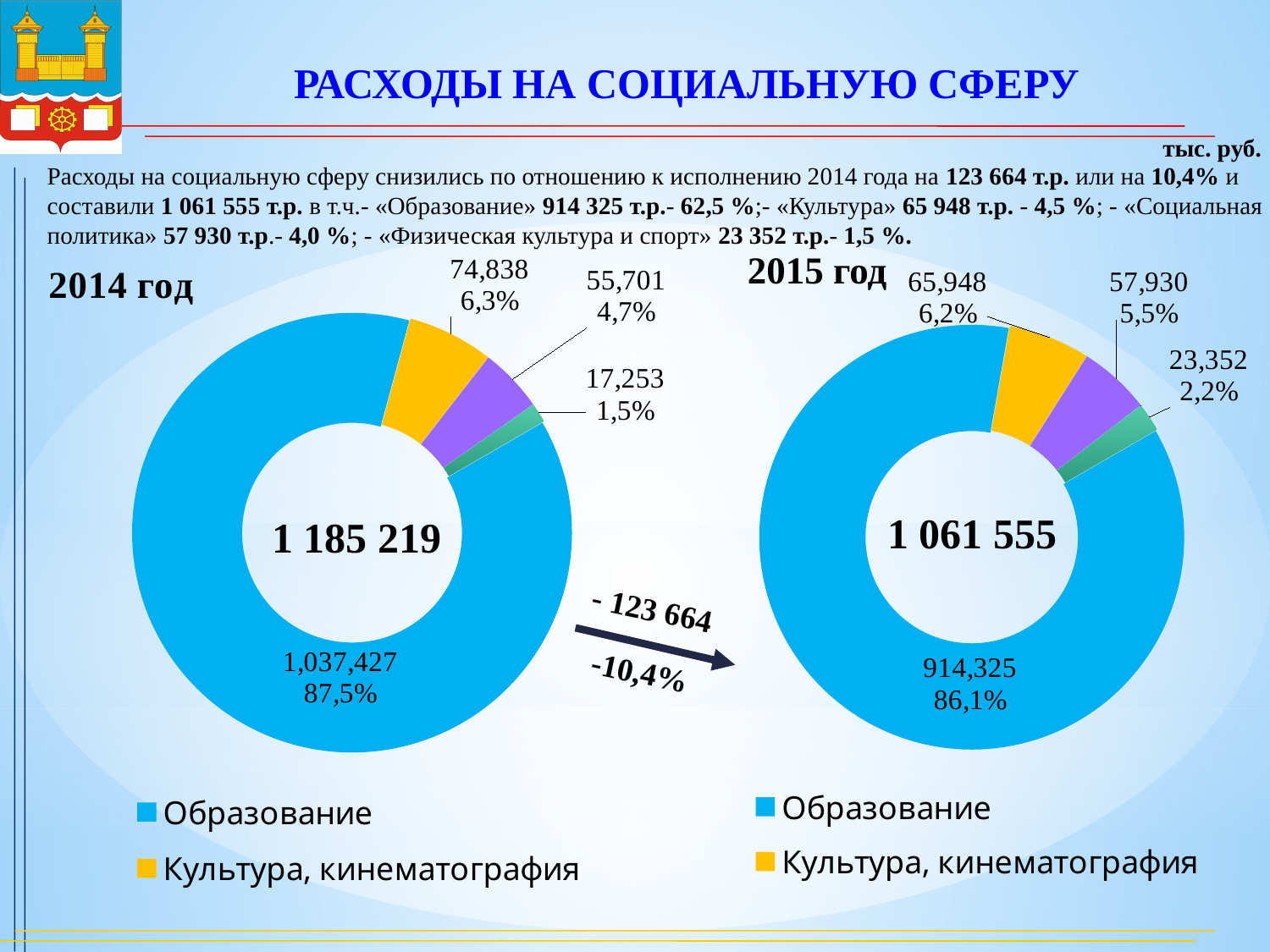
In the 2014 год chart, what is the value for Образование? 1,037,427 In the 2015 год chart, which category has the largest slice? Образование What kind of chart is used for the 2014 год chart? Doughnut (pie) chart In the 2015 год chart, what is the value for Культура, кинематография? 65,948 What total is printed in the centre of the 2015 год chart? 1 061 555 How many slices does the 2015 год chart have? 4 In the 2014 год chart, what share of the total does Образование account for? 87,5% What colour represents Образование in the 2014 год chart? Blue Which chart shows a larger value for Культура, кинематография, 2014 год or 2015 год? 2014 год How many entries does the legend of the 2014 год chart list? 2 In the 2015 год chart, what share of the total does Культура, кинематография account for? 6,2% What is the difference between the Образование value in the 2014 год chart and the Образование value in the 2015 год chart? 123,102